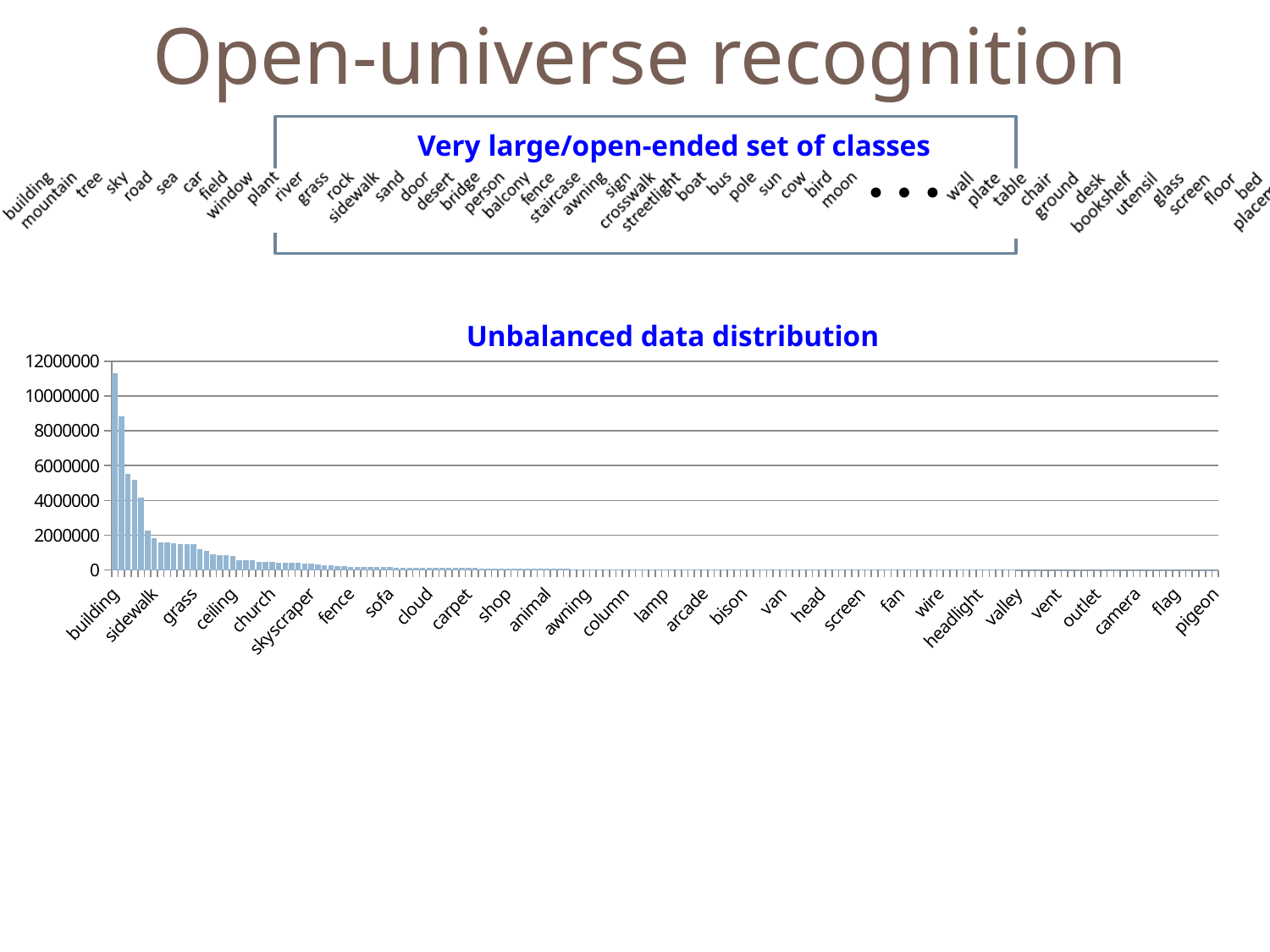
What is the highest tick value shown on the y axis of the "Unbalanced data distribution" chart? 12000000 What kind of chart is the "Unbalanced data distribution" chart? bar chart In the "Unbalanced data distribution" chart, which is larger, the value for building or the value for pigeon? building In the "Unbalanced data distribution" chart, which is larger, the value for building or the value for sidewalk? building In the "Unbalanced data distribution" chart, is the value for sidewalk greater or less than 4000000? less What is the title of the chart on the slide? Unbalanced data distribution In the "Unbalanced data distribution" chart, do the values generally rise or fall from left to right along the x axis? fall In the "Unbalanced data distribution" chart, is the value for church greater or less than 2000000? less In the "Unbalanced data distribution" chart, is the value for pigeon greater or less than 2000000? less Which category has the highest value in the "Unbalanced data distribution" chart? building